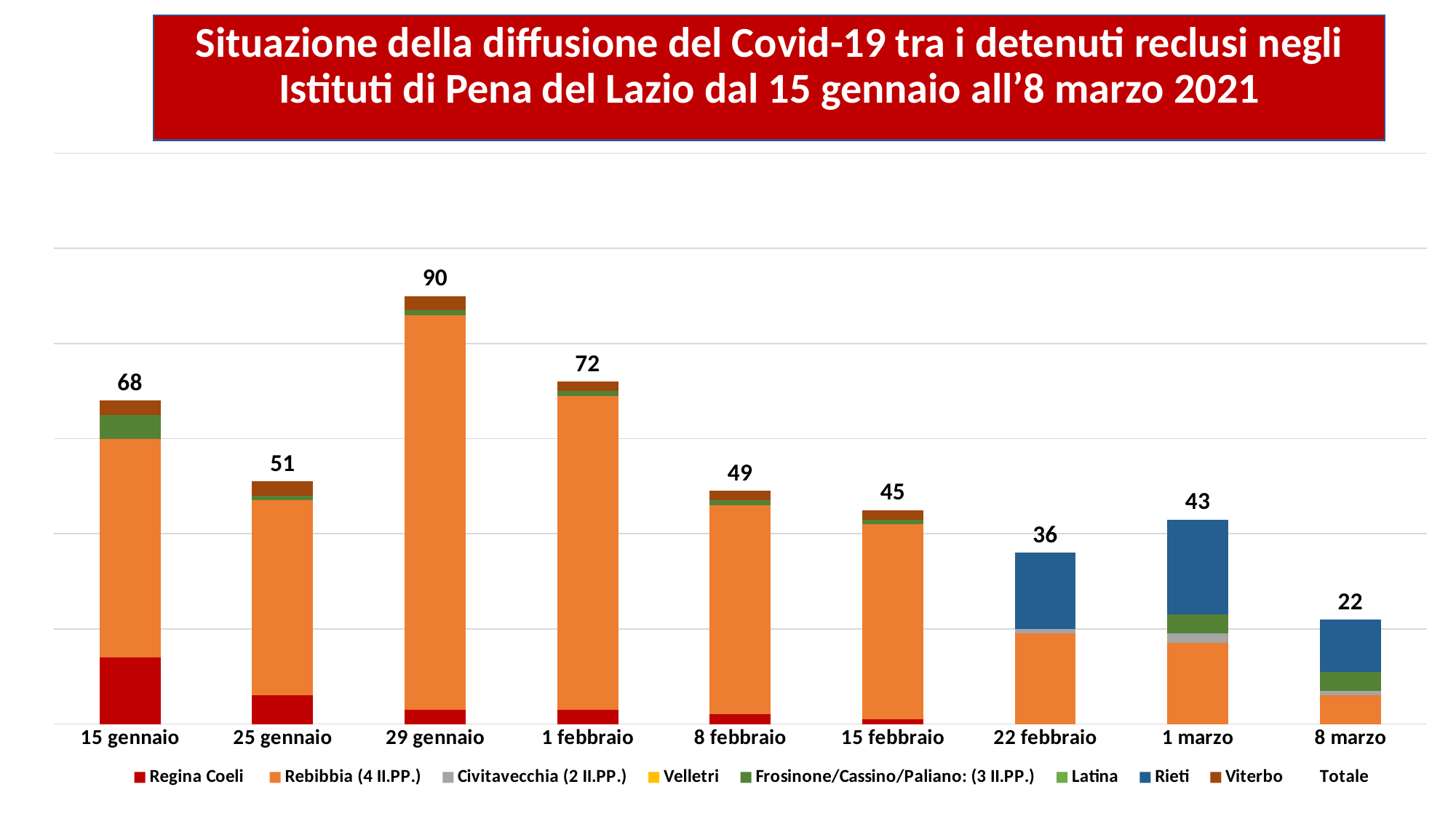
What is the difference between the totals for 29 gennaio and 1 febbraio? 18 Which date has the lowest total? 8 marzo How many dates are shown on the x axis? 9 What is the total value shown for 29 gennaio? 90 Which legend entry is shown in blue? Rieti How many entries does the legend list? 9 What kind of chart is shown on the slide? stacked bar chart What is the total value shown for 8 marzo? 22 What is the total value shown for 22 febbraio? 36 What is the difference between the totals for 15 gennaio and 25 gennaio? 17 Which is larger, the total for 1 marzo or the total for 22 febbraio? 1 marzo Which date has the highest total? 29 gennaio